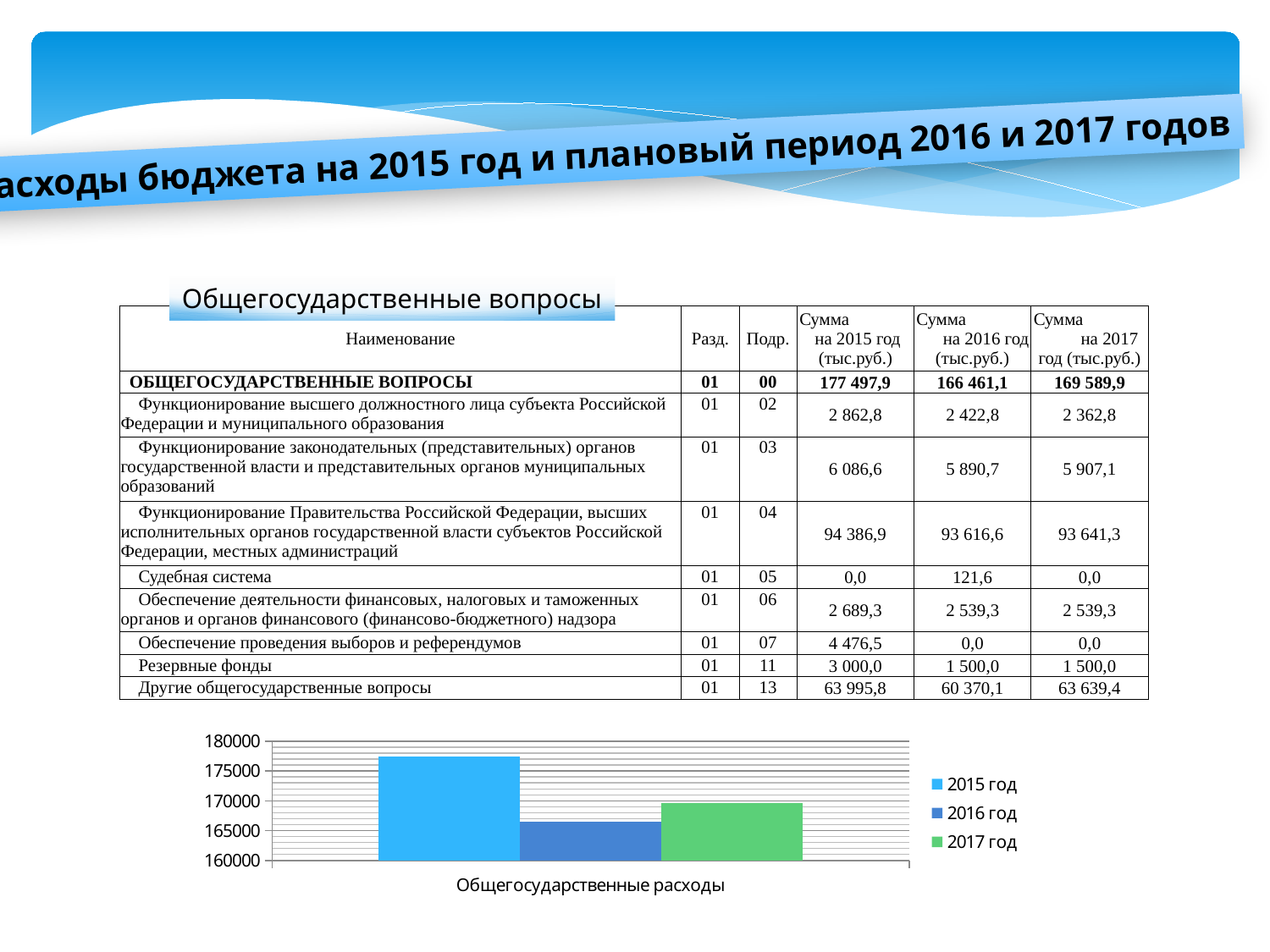
Which series has the highest bar in the chart? 2015 год How many series does the legend of the chart list? 3 In the chart, which bar is taller: 2015 год or 2017 год? 2015 год In the chart, is the bar for 2016 год greater or less than 170000? less What is the category label shown on the x axis of the chart? Общегосударственные расходы What kind of chart is shown at the bottom of the slide? bar chart How many categories are shown on the x axis of the chart? 1 In the chart, is the bar for 2015 год greater or less than 175000? greater In the chart, is the bar for 2017 год greater or less than 165000? greater Which legend entry is shown in green in the chart? 2017 год In the chart, which bar is taller: 2016 год or 2017 год? 2017 год Which series has the lowest bar in the chart? 2016 год